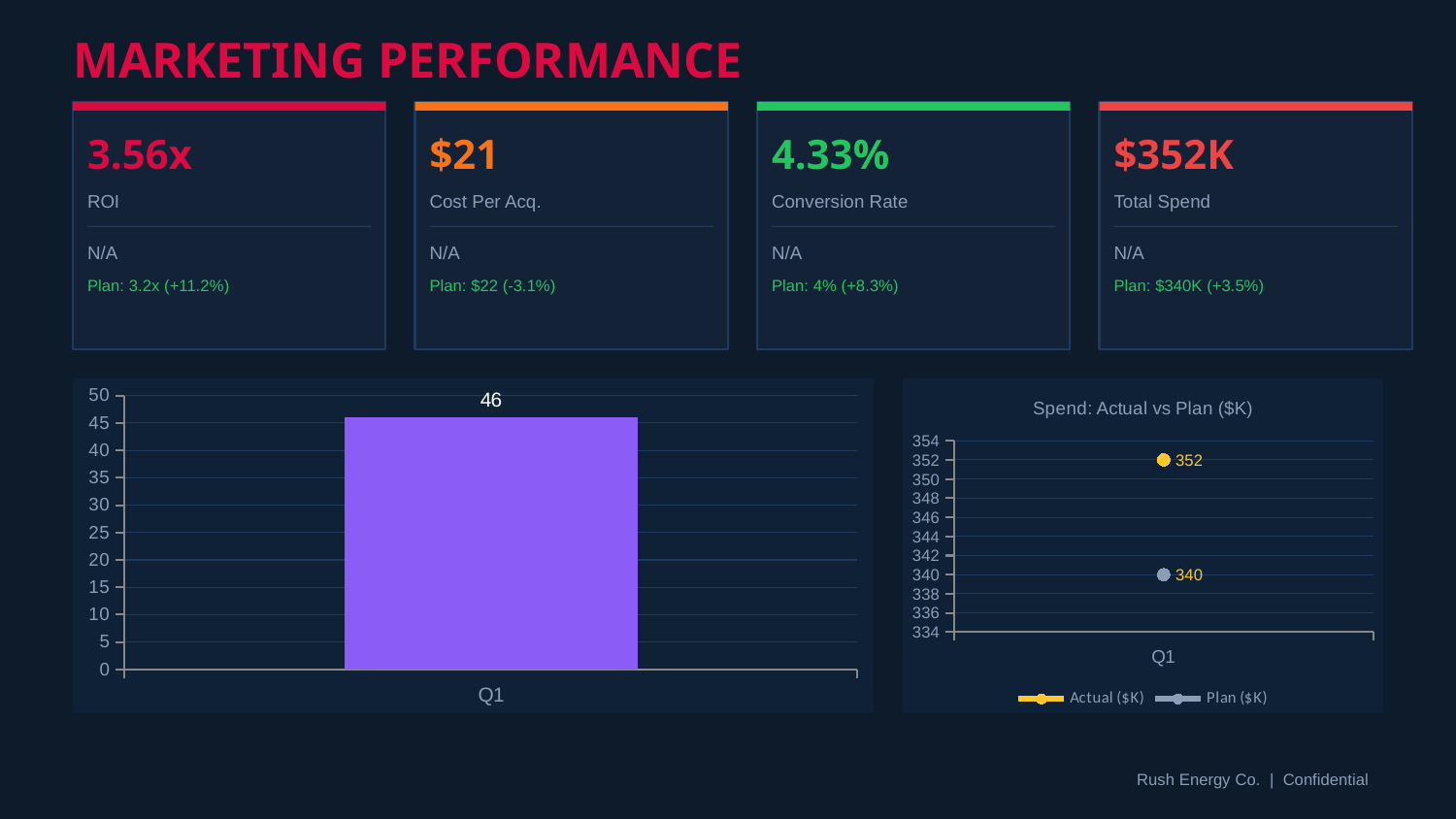
What is the title of the chart on the right of the slide? Spend: Actual vs Plan ($K) In the 'Spend: Actual vs Plan ($K)' chart, which is larger for Q1, Actual ($K) or Plan ($K)? Actual ($K) In the 'Spend: Actual vs Plan ($K)' chart, what colour is the Actual ($K) marker? yellow In the 'Spend: Actual vs Plan ($K)' chart, what is the Actual ($K) value for Q1? 352 In the left bar chart, what is the value for Q1? 46 In the 'Spend: Actual vs Plan ($K)' chart, what is the difference between the Actual ($K) and Plan ($K) values for Q1? 12 In the 'Spend: Actual vs Plan ($K)' chart, is the Plan ($K) value for Q1 greater or less than 344? less How many categories are shown on the x axis of the left bar chart? 1 How many series does the legend of the 'Spend: Actual vs Plan ($K)' chart list? 2 In the left bar chart, is the value for Q1 greater or less than 40? greater In the 'Spend: Actual vs Plan ($K)' chart, what is the Plan ($K) value for Q1? 340 What kind of chart is the chart on the left of the slide? bar chart